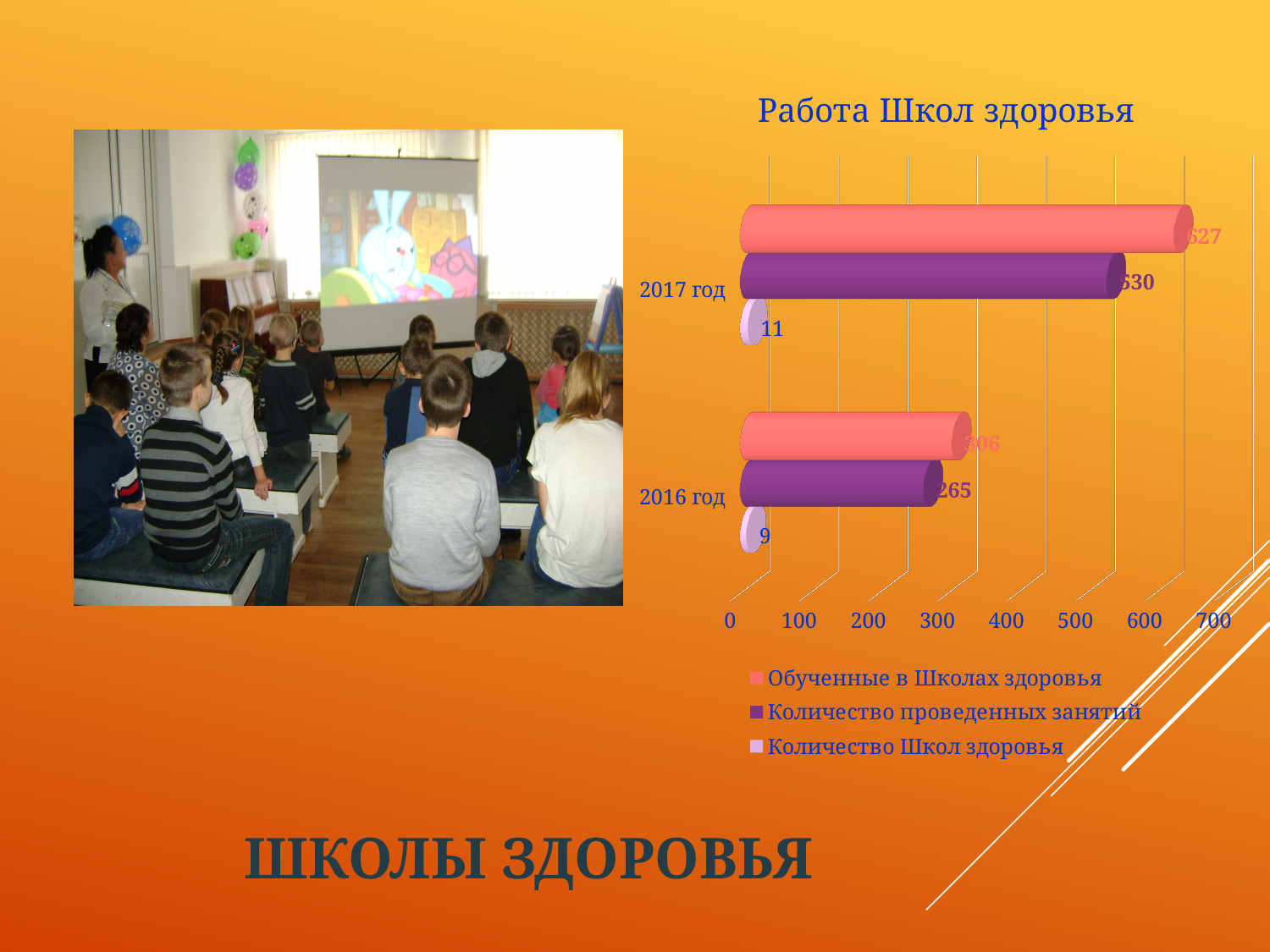
In the chart 'Работа Школ здоровья', what is the value of 'Количество Школ здоровья' for 2017 год? 11 How many year categories are shown in the chart 'Работа Школ здоровья'? 2 In the chart 'Работа Школ здоровья', which year has the larger value for 'Обученные в Школах здоровья'? 2017 год In the chart 'Работа Школ здоровья', is the value of 'Обученные в Школах здоровья' for 2016 год greater or less than 400? less In the chart 'Работа Школ здоровья', by how much did 'Количество Школ здоровья' increase from 2016 год to 2017 год? 2 What type of chart is 'Работа Школ здоровья'? bar chart In the chart 'Работа Школ здоровья', what is the value of 'Количество Школ здоровья' for 2016 год? 9 In the chart 'Работа Школ здоровья', what is the value of 'Количество проведенных занятий' for 2017 год? 530 In the chart 'Работа Школ здоровья', what is the difference between 'Количество проведенных занятий' in 2017 год and 2016 год? 265 How many series does the legend of the chart 'Работа Школ здоровья' list? 3 In the chart 'Работа Школ здоровья', what is the value of 'Количество проведенных занятий' for 2016 год? 265 In the chart 'Работа Школ здоровья', what is the value of 'Обученные в Школах здоровья' for 2017 год? 627